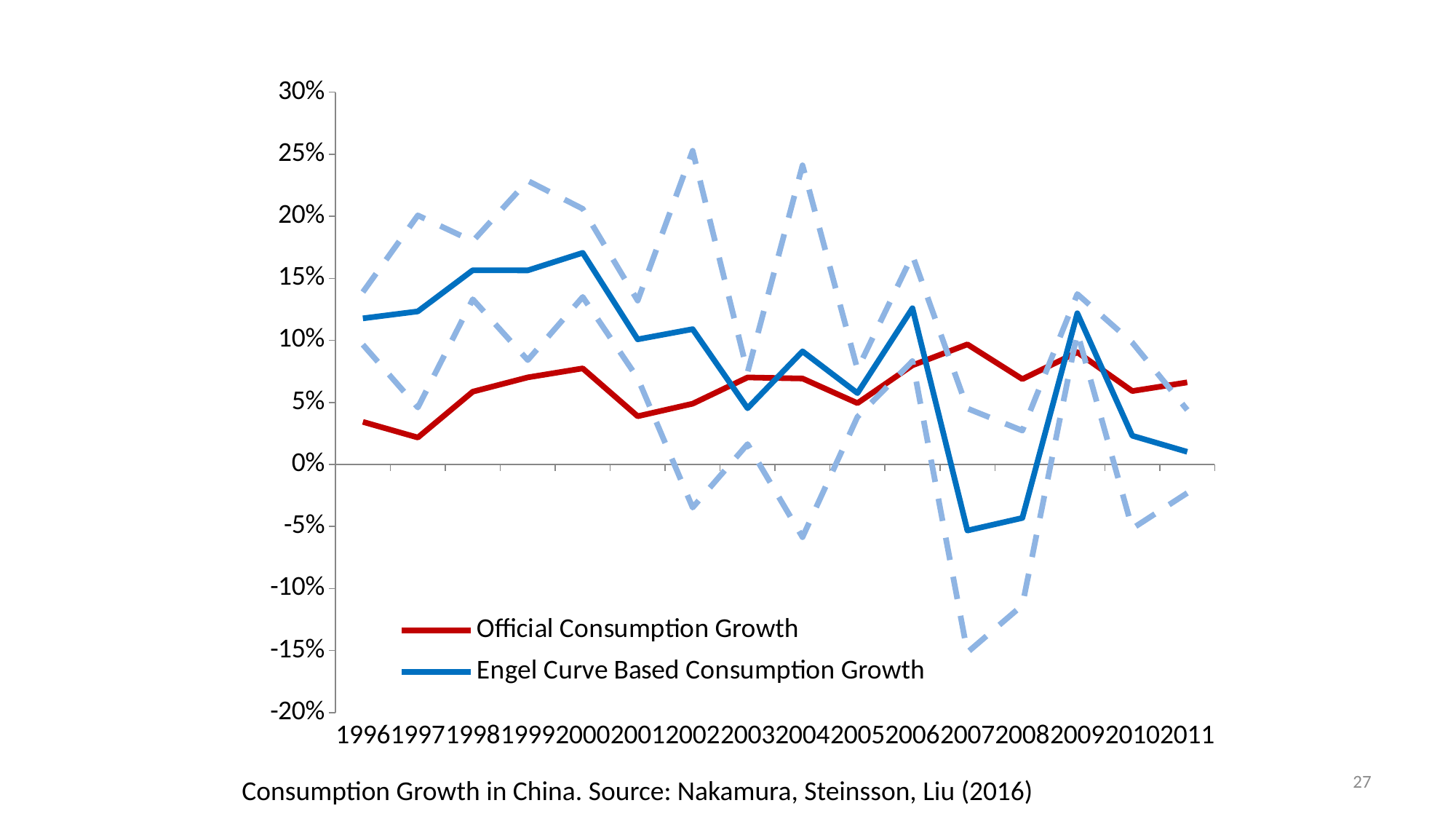
In which year is Engel Curve Based Consumption Growth lowest? 2007 In 2007, which series has the larger value: Official Consumption Growth or Engel Curve Based Consumption Growth? Official Consumption Growth How many years are shown on the x axis? 16 In which year is Engel Curve Based Consumption Growth highest? 2000 Does Engel Curve Based Consumption Growth rise or fall from 2009 to 2011? fall In which year is Official Consumption Growth lowest? 1997 What colour is the line for Official Consumption Growth? Red How many series does the legend list? 2 What kind of chart is shown on the slide? Line chart Is the value for Engel Curve Based Consumption Growth in 2007 greater or less than 0%? less Is the value for Engel Curve Based Consumption Growth in 2000 greater or less than 15%? greater In 1996, which series has the larger value: Official Consumption Growth or Engel Curve Based Consumption Growth? Engel Curve Based Consumption Growth